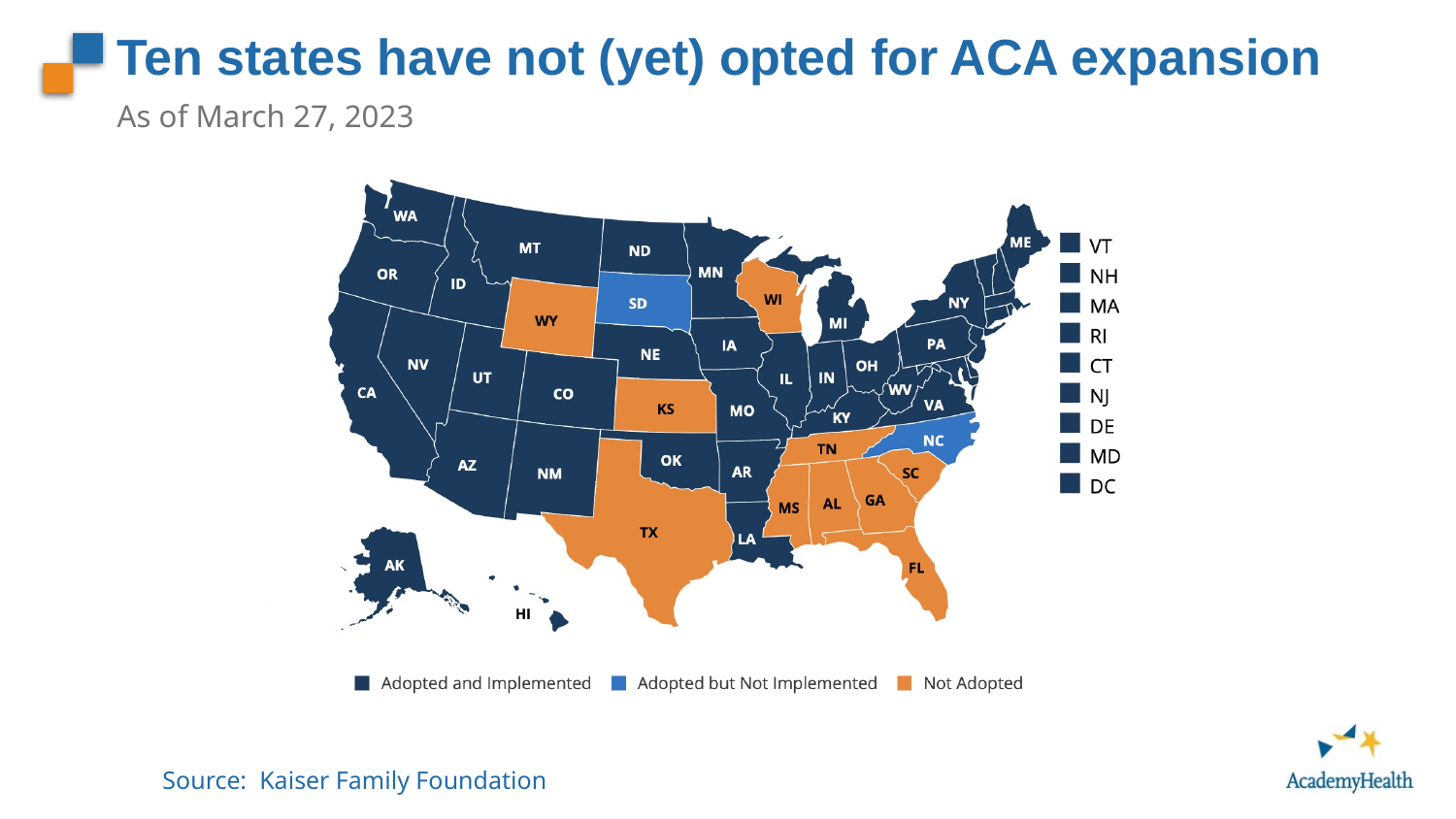
What is the title of the slide containing the map? Ten states have not (yet) opted for ACA expansion Which category is South Dakota (SD) shown in on the map? Adopted but Not Implemented Which category is Wisconsin (WI) shown in on the map? Not Adopted Which category is North Carolina (NC) shown in on the map? Adopted but Not Implemented How many states are shown in the 'Not Adopted' category on the map? 10 Which category is Florida (FL) shown in on the map? Not Adopted Which category is California (CA) shown in on the map? Adopted and Implemented What colour is used on the map for states in the 'Not Adopted' category? Orange Which category is Texas (TX) shown in on the map? Not Adopted What kind of chart is shown on the slide? A map How many states are shown in the 'Adopted but Not Implemented' category on the map? 2 How many categories does the legend at the bottom of the map list? 3